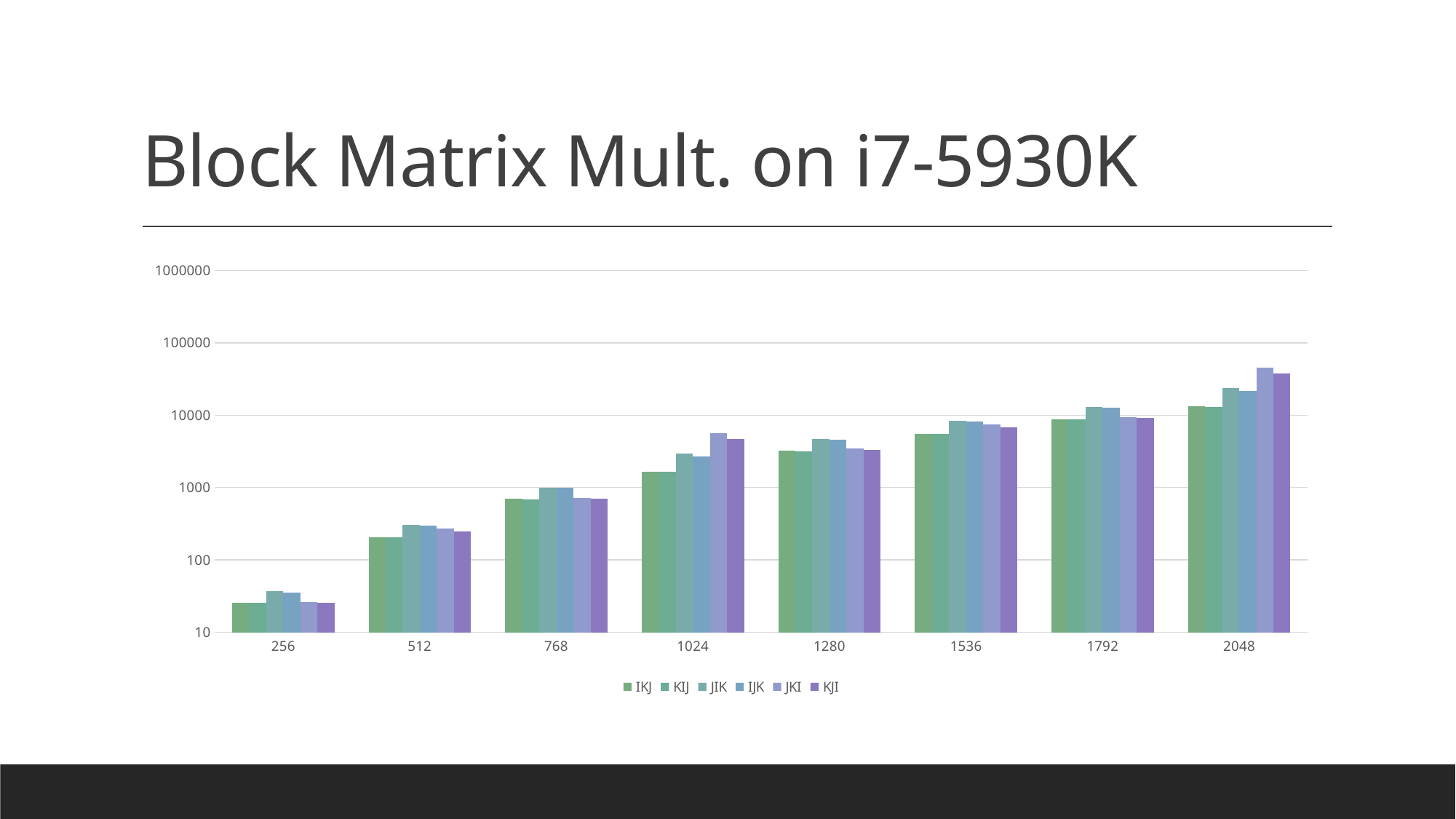
Do the values generally rise or fall as the matrix size increases along the x axis? rise Is the value for JKI at size 512 greater or less than 100? greater What is the title of the slide containing the chart? Block Matrix Mult. on i7-5930K Is the value for IKJ at size 1536 greater or less than 10000? less At size 1024, which is larger, the value for JKI or the value for IKJ? JKI Which series has the highest value at size 2048? JKI Which series is listed last in the legend? KJI How many series does the legend list? 6 How many matrix-size categories are shown on the x axis? 8 Is the value for IKJ at size 256 greater or less than 100? less What kind of chart is shown on the slide? bar chart